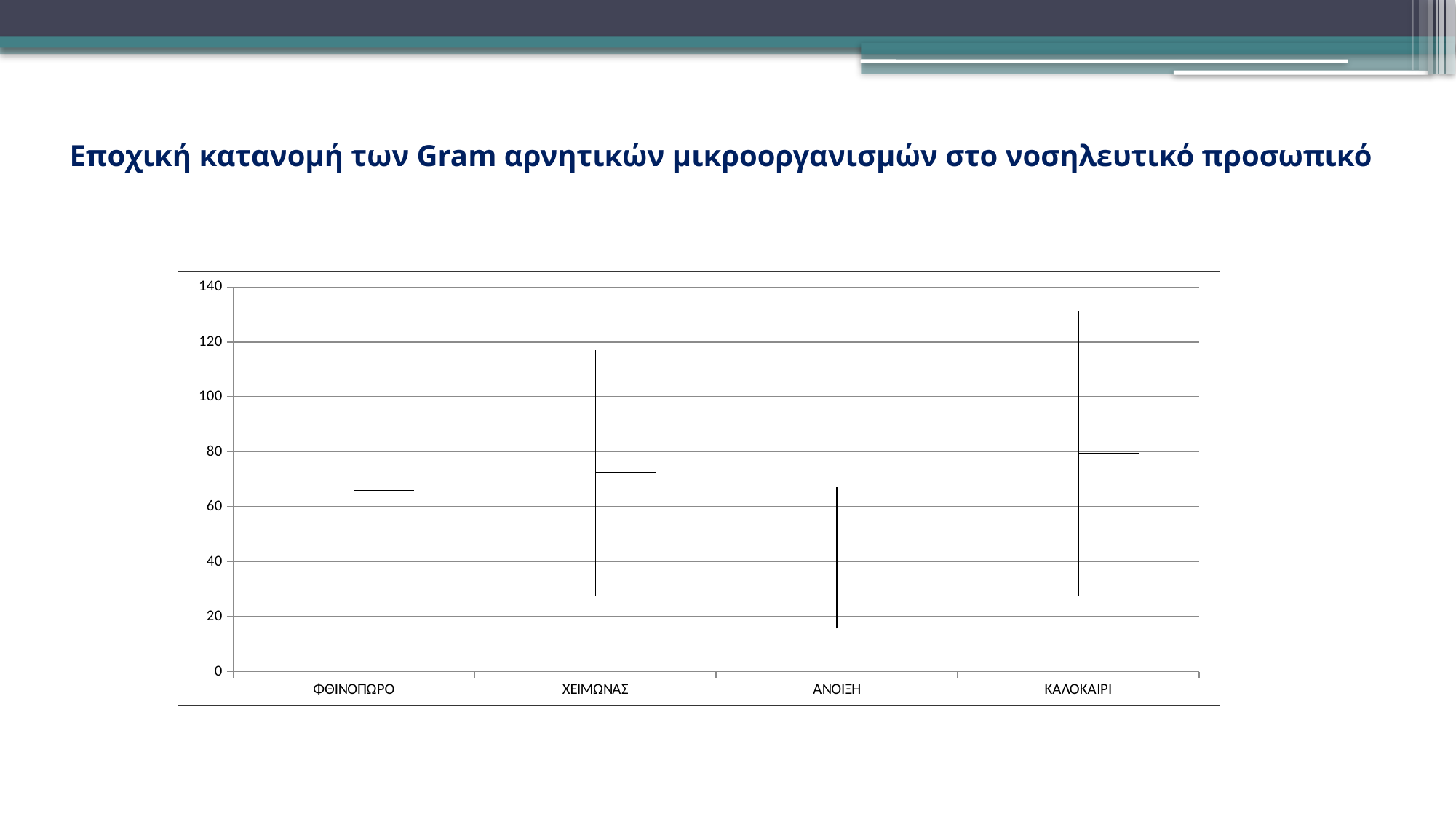
What is the highest value shown on the vertical axis of the chart? 140 Is the top of the vertical line for ΚΑΛΟΚΑΙΡΙ greater or less than 120? greater What is the title of the slide above the chart? Εποχική κατανομή των Gram αρνητικών μικροοργανισμών στο νοσηλευτικό προσωπικό Which category has the highest horizontal tick mark (close value) in the chart? ΚΑΛΟΚΑΙΡΙ Which category has the lowest horizontal tick mark (close value) in the chart? ΑΝΟΙΞΗ Is the horizontal tick mark value for ΑΝΟΙΞΗ greater or less than 60? less Which has the higher horizontal tick mark value, ΚΑΛΟΚΑΙΡΙ or ΑΝΟΙΞΗ? ΚΑΛΟΚΑΙΡΙ How many categories are shown on the x axis of the chart? 4 Which category's vertical line reaches the highest point in the chart? ΚΑΛΟΚΑΙΡΙ What kind of chart is shown on the slide? stock chart (high-low-close) Which category's vertical line has the lowest top point in the chart? ΑΝΟΙΞΗ Is the horizontal tick mark value for ΦΘΙΝΟΠΩΡΟ greater or less than 60? greater